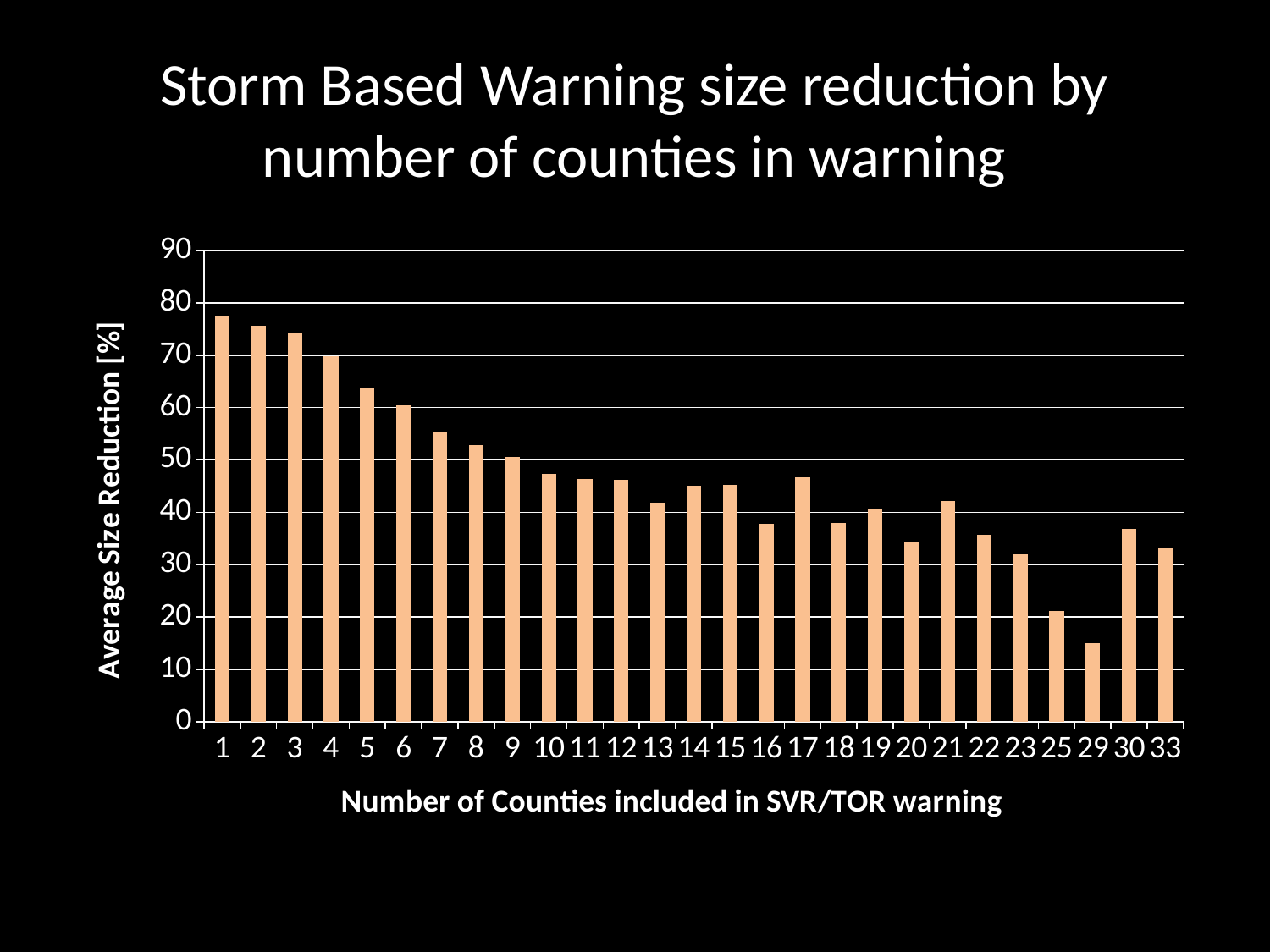
Which number of counties has the lowest average size reduction? 29 What kind of chart is shown on the slide? bar chart Is the value for 5 counties greater or less than 60? greater Which has a larger average size reduction, 16 counties or 17 counties? 17 counties Is the value for 1 county greater or less than 70? greater Is the value for 16 counties greater or less than 40? less Do the values generally rise or fall as the number of counties increases along the x axis? fall Which has a larger average size reduction, 3 counties or 6 counties? 3 counties What is the label of the vertical axis? Average Size Reduction [%] How many bars (categories) are plotted on the chart? 27 Which number of counties has the highest average size reduction? 1